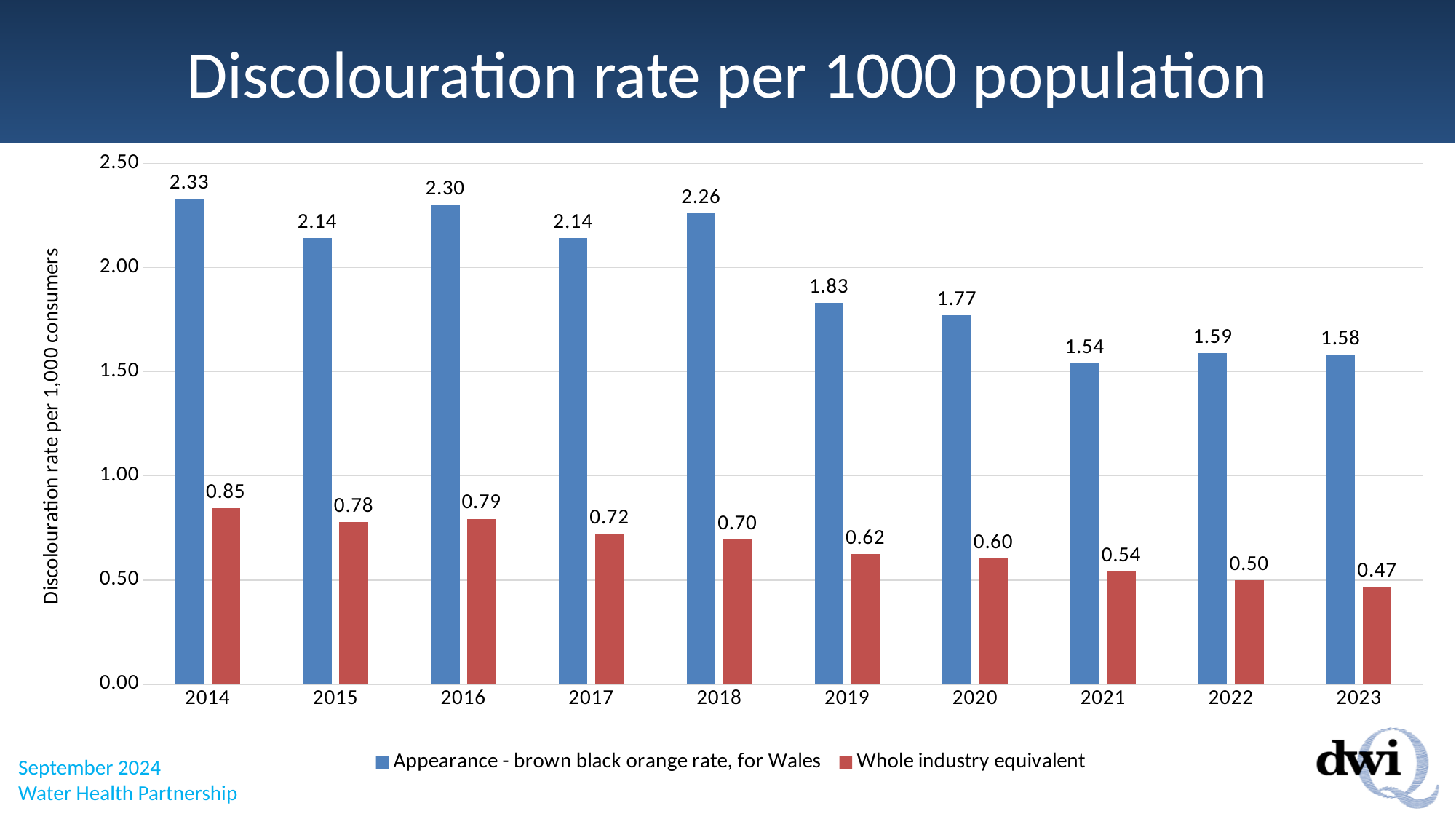
What is the value for 'Appearance - brown black orange rate, for Wales' in 2014? 2.33 In which year is the 'Appearance - brown black orange rate, for Wales' value highest? 2014 What is the value for 'Whole industry equivalent' in 2017? 0.72 Which is larger: the 'Appearance - brown black orange rate, for Wales' value in 2016 or in 2018? 2016 What is the value for 'Whole industry equivalent' in 2023? 0.47 In which year is the 'Appearance - brown black orange rate, for Wales' value lowest? 2021 How many series does the legend list? 2 What kind of chart is shown on the slide? Bar chart In which year is the 'Whole industry equivalent' value lowest? 2023 How many years are shown on the x axis? 10 What is the difference between the 'Appearance - brown black orange rate, for Wales' value and the 'Whole industry equivalent' value in 2020? 1.17 Does the 'Whole industry equivalent' series generally rise or fall from 2014 to 2023? Fall